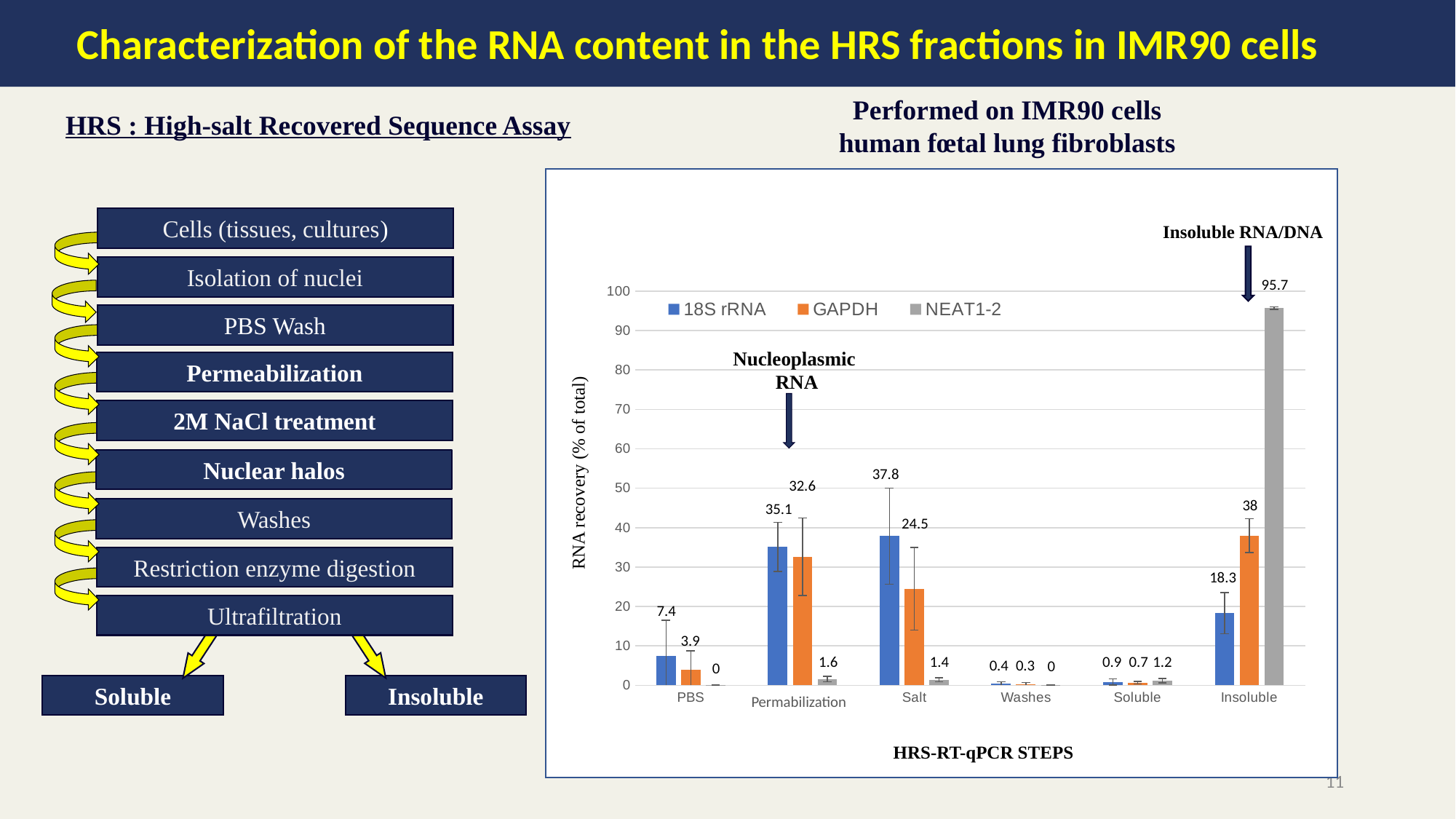
What is the value for GAPDH in the Permabilization step? 32.6 What is the value for 18S rRNA in the PBS step? 7.4 What type of chart is shown on the slide? bar chart How many categories are shown on the x axis of the chart? 6 How many series does the chart legend list? 3 What is the value for 18S rRNA in the Salt step? 37.8 What is the RNA recovery value for NEAT1-2 in the Insoluble step? 95.7 Which step has the highest value for NEAT1-2? Insoluble In the Salt step, which is larger: the 18S rRNA value or the GAPDH value? 18S rRNA What is the label of the x axis of the chart? HRS-RT-qPCR STEPS What is the difference between the GAPDH and 18S rRNA values in the Insoluble step? 19.7 Which step has the highest value for 18S rRNA? Salt